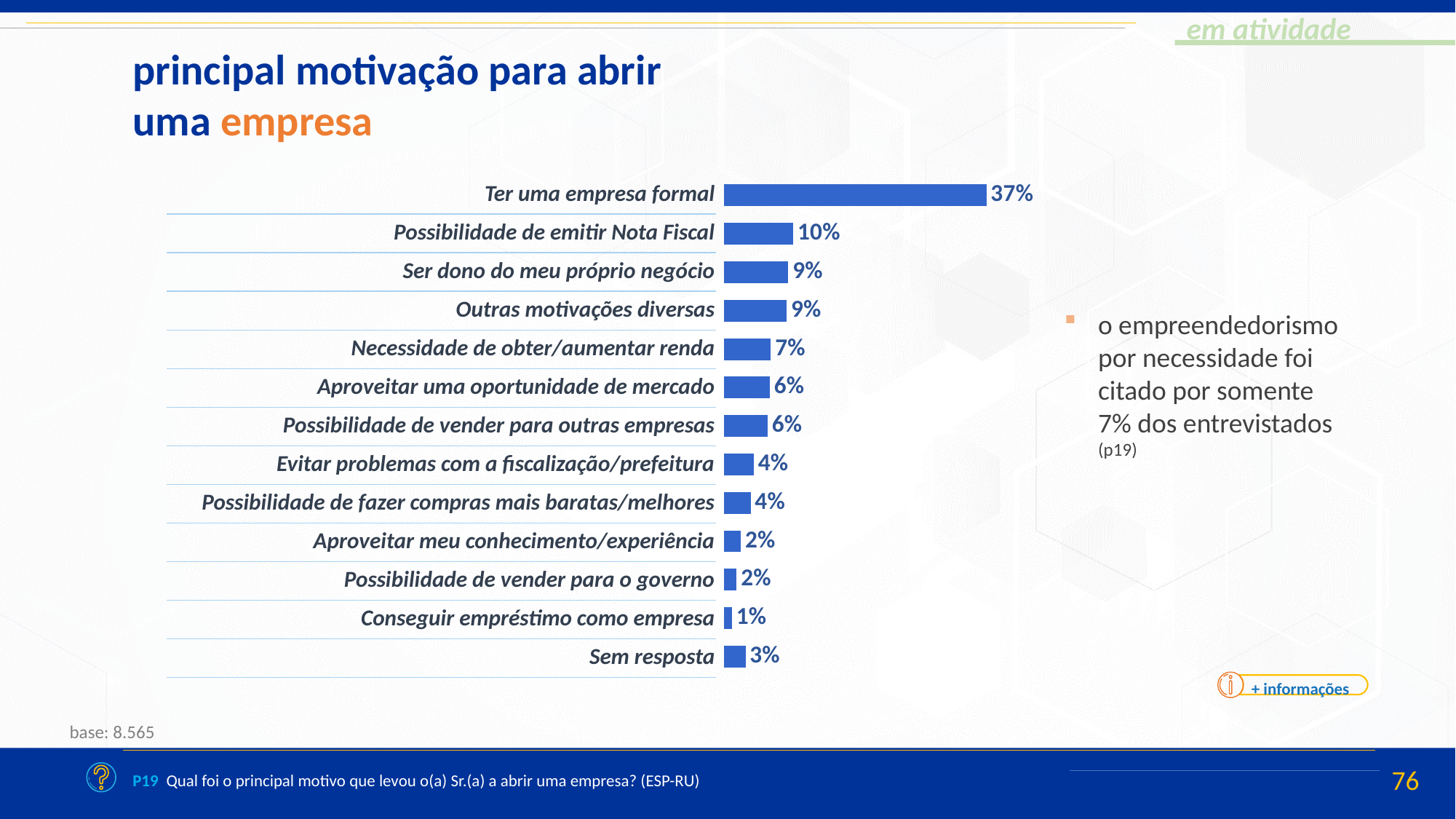
What is the difference between "Ter uma empresa formal" and "Possibilidade de emitir Nota Fiscal"? 27% Which is larger: "Aproveitar uma oportunidade de mercado" or "Aproveitar meu conhecimento/experiência"? Aproveitar uma oportunidade de mercado What is the value for "Sem resposta"? 3% What is the difference between "Ser dono do meu próprio negócio" and "Evitar problemas com a fiscalização/prefeitura"? 5% What is the value for "Possibilidade de emitir Nota Fiscal"? 10% What is the value for "Ter uma empresa formal"? 37% What is the value for "Necessidade de obter/aumentar renda"? 7% What is the base (sample size) stated below the chart? 8.565 Which category has the lowest value? Conseguir empréstimo como empresa Which category has the highest value? Ter uma empresa formal How many categories are shown in the chart? 13 What kind of chart is shown on the slide? Bar chart